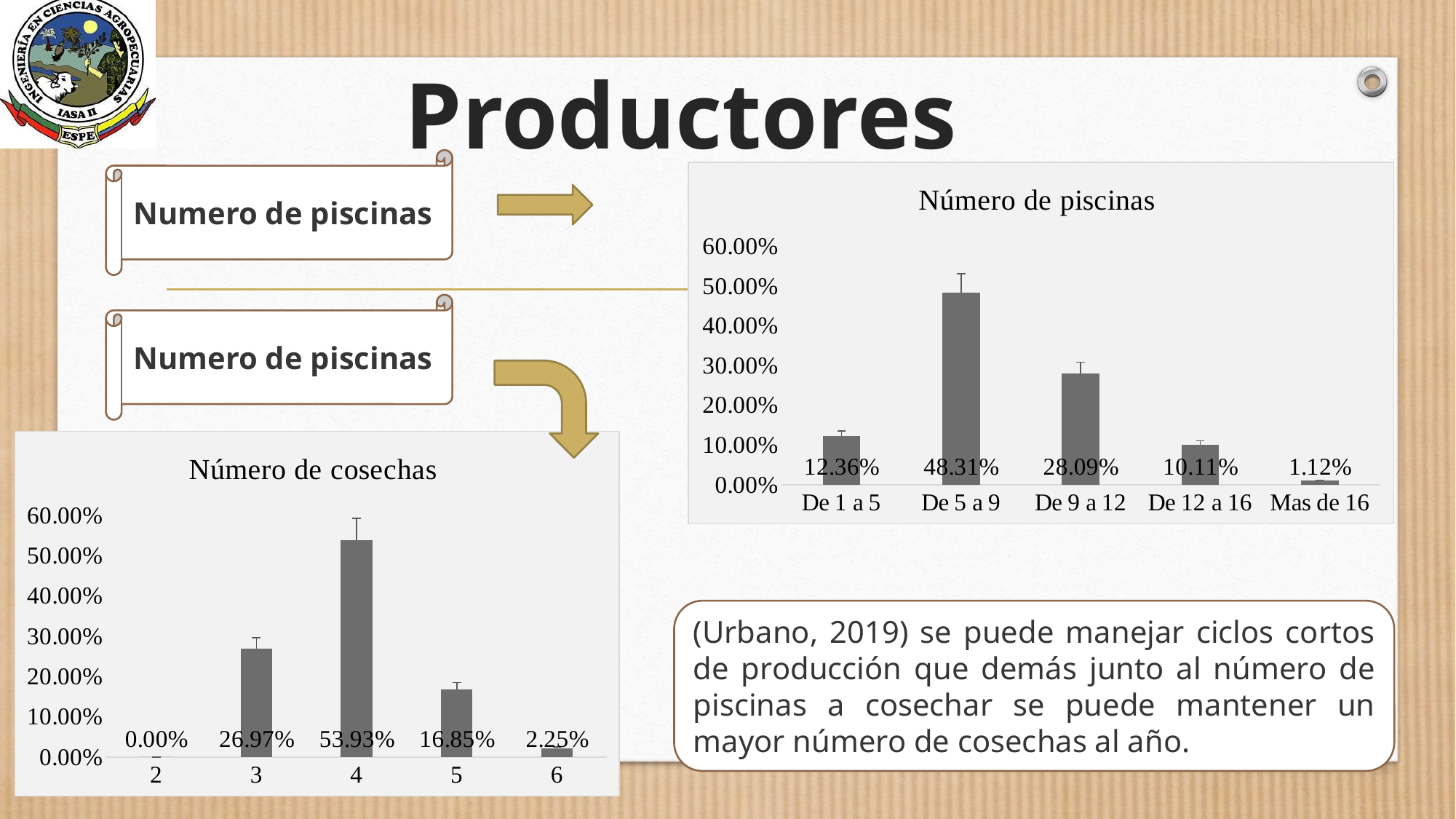
In the 'Número de piscinas' chart, what is the difference between the values for 'De 5 a 9' and 'De 9 a 12'? 20.22% In the 'Número de piscinas' chart, which category has the highest value? De 5 a 9 In the 'Número de cosechas' chart, what is the value for category 4? 53.93% In the 'Número de piscinas' chart, which category has the lowest value? Mas de 16 In the 'Número de piscinas' chart, what is the value for 'Mas de 16'? 1.12% What kind of chart is the 'Número de cosechas' chart? Bar chart In the 'Número de cosechas' chart, what is the value for category 3? 26.97% In the 'Número de piscinas' chart, what is the value for 'De 5 a 9'? 48.31% In the 'Número de cosechas' chart, which category has the lowest value? 2 In the 'Número de piscinas' chart, how many categories are shown on the x axis? 5 In the 'Número de cosechas' chart, which is larger, the value for category 5 or the value for category 6? 5 In the 'Número de cosechas' chart, what is the difference between the values for category 4 and category 3? 26.96%